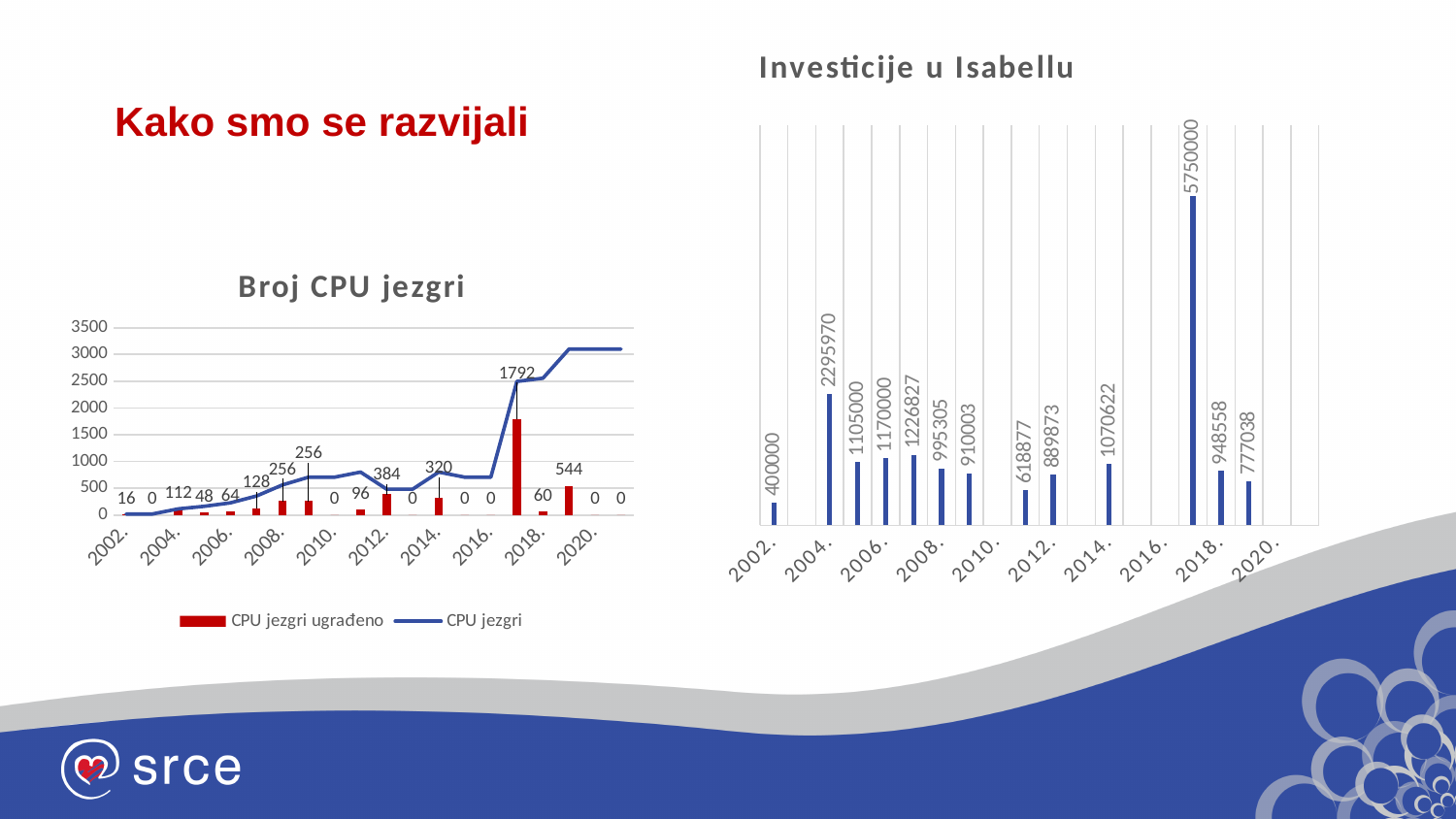
In the chart titled 'Investicije u Isabellu', which year has the highest value? 2017. In the chart titled 'Broj CPU jezgri', what are the two legend entries? CPU jezgri ugrađeno, CPU jezgri In the chart titled 'Investicije u Isabellu', how many bars are plotted? 13 In the chart titled 'Investicije u Isabellu', what is the value for 2002? 400000 In the chart titled 'Investicije u Isabellu', which is larger, the value for 2005 or the value for 2006? 2006. In the chart titled 'Investicije u Isabellu', what is the highest value shown? 5750000 In the chart titled 'Investicije u Isabellu', which year has the lowest value? 2002. In the chart titled 'Broj CPU jezgri', what is the largest value labelled on a bar? 1792 In the chart titled 'Broj CPU jezgri', how many series does the legend list? 2 In the chart titled 'Investicije u Isabellu', what is the value for 2004? 2295970 In the chart titled 'Investicije u Isabellu', what is the difference between the highest value (5750000) and the second highest (2295970)? 3454030 In the chart titled 'Broj CPU jezgri', is the value of the 'CPU jezgri' line at 2020 greater or less than 3000? greater